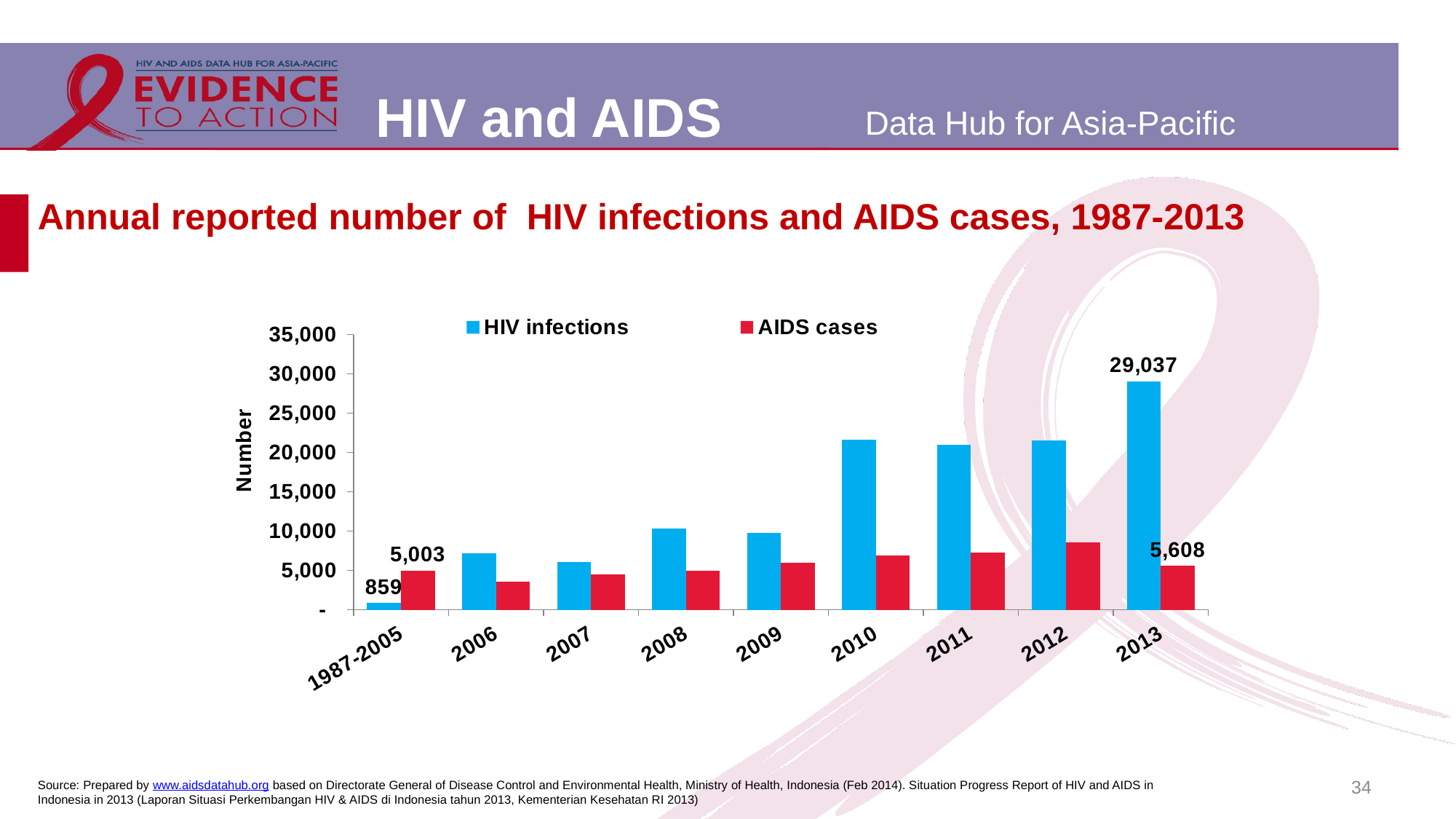
What is the reported number of HIV infections for 1987-2005? 859 Which year has more HIV infections, 2009 or 2010? 2010 Is the number of HIV infections in 2010 greater or less than 20,000? greater Do AIDS cases rise or fall from 2006 to 2012? rise Which period has the lowest number of HIV infections? 1987-2005 What is the reported number of AIDS cases in 2013? 5,608 Which period has the highest number of HIV infections? 2013 How many periods are shown on the x axis? 9 What is the reported number of HIV infections in 2013? 29,037 What is the difference between HIV infections and AIDS cases in 2013? 23,429 What is the reported number of AIDS cases for 1987-2005? 5,003 How many series does the legend list? 2